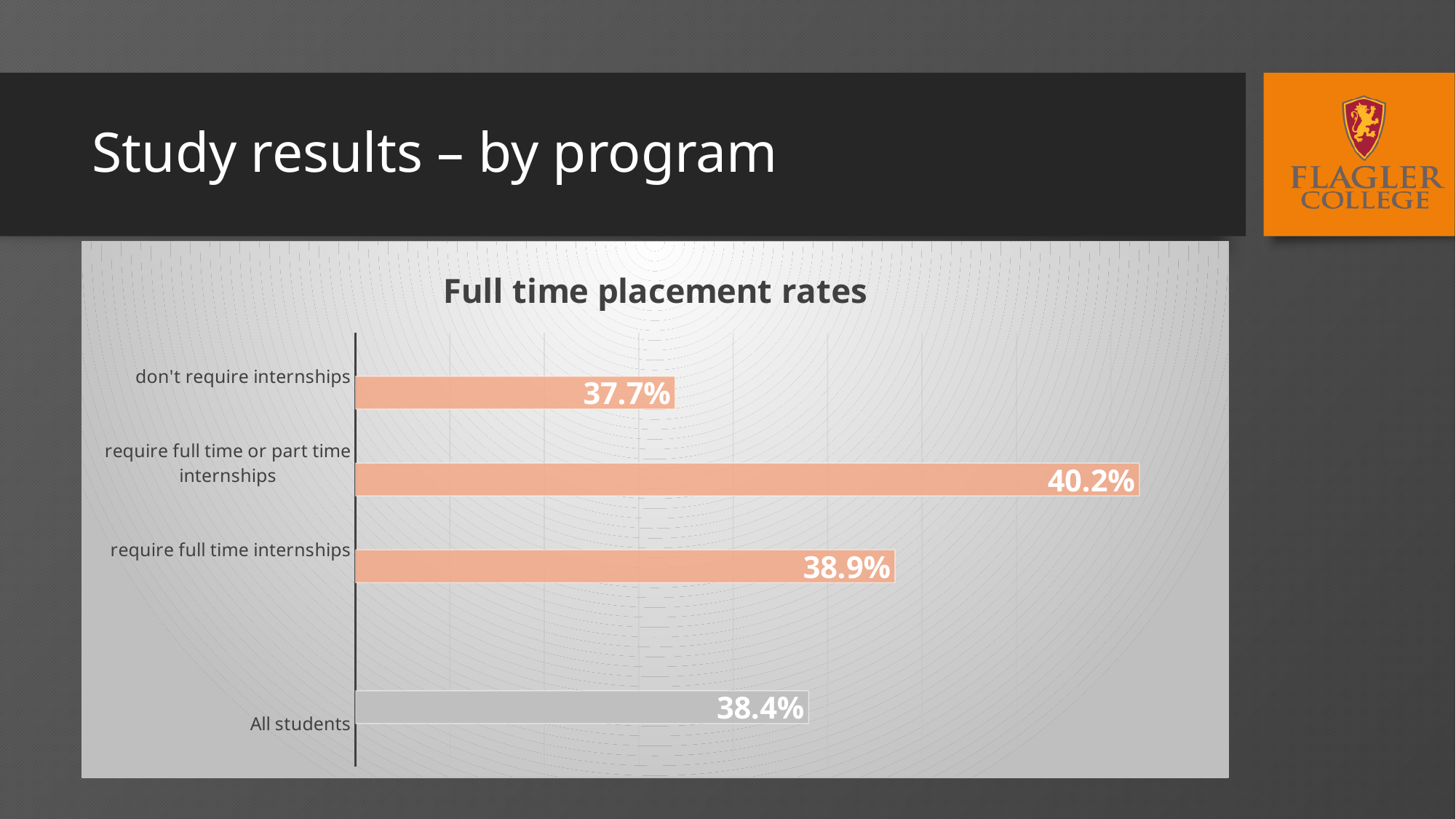
What is the full time placement rate for All students? 38.4% Which category has the highest full time placement rate? require full time or part time internships What is the difference between the placement rate for programs that require full time internships and All students? 0.5% How many categories are shown in the chart? 4 What is the title of the chart? Full time placement rates What is the full time placement rate for programs that require full time internships? 38.9% Which category has the lowest full time placement rate? don't require internships What is the difference between the placement rate for programs that require full time or part time internships and those that don't require internships? 2.5% What kind of chart is shown on the slide? bar chart What is the full time placement rate for programs that require full time or part time internships? 40.2% What is the full time placement rate for programs that don't require internships? 37.7% Which is larger: the placement rate for programs that require full time internships or for programs that don't require internships? require full time internships